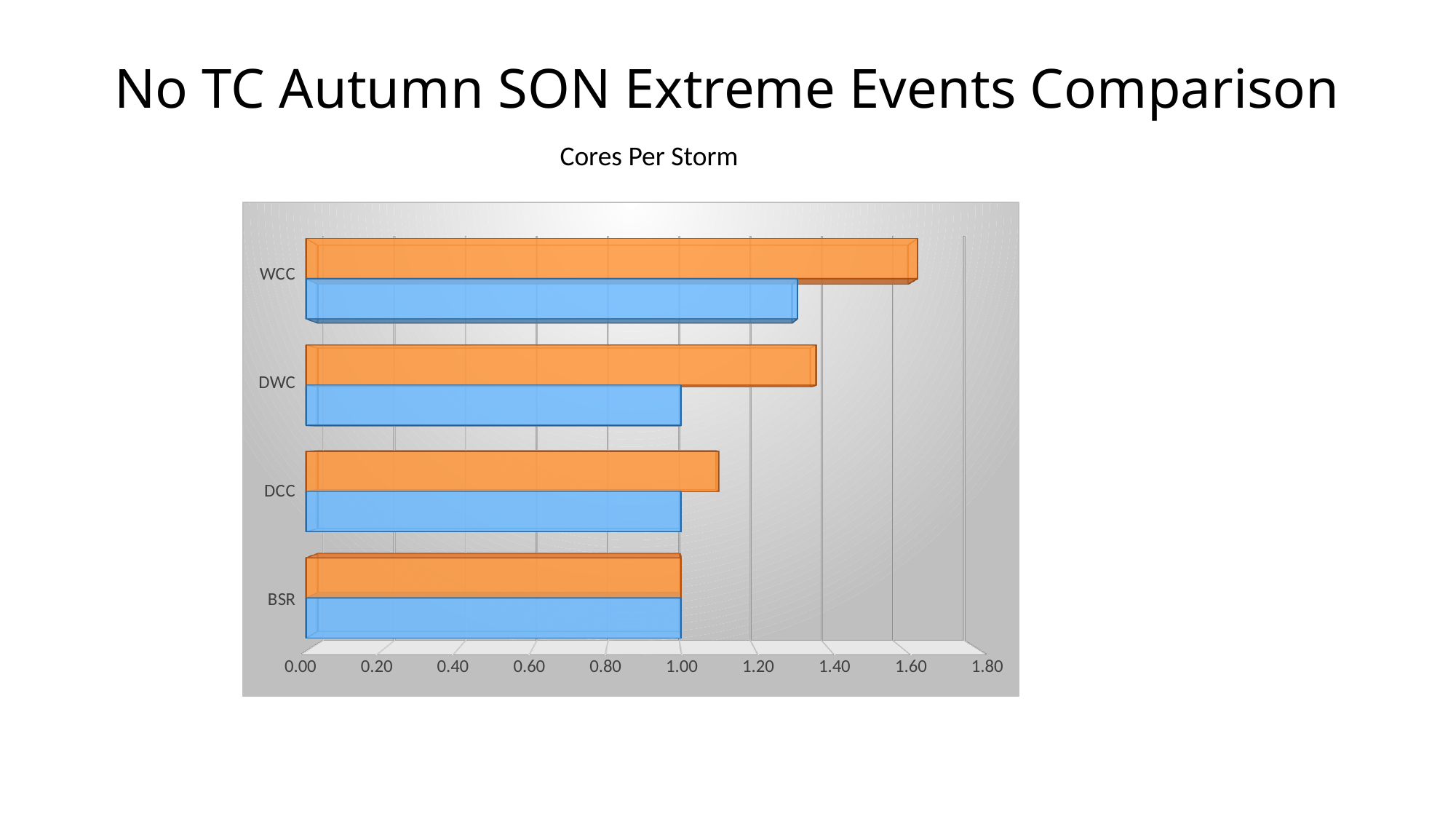
Is the value of the orange bar for DWC greater or less than 1.20? greater For WCC, which bar is longer, the orange one or the blue one? orange What is the title of the chart? Cores Per Storm Which has the larger orange bar, WCC or DWC? WCC Which category has the longest orange bar? WCC Is the value of the orange bar for DCC greater or less than 1.20? less What two colours are used for the bars in the chart? orange and blue How many categories are shown on the chart's vertical axis? 4 Is the value of the blue bar for WCC greater or less than 1.20? greater Which category has the shortest orange bar? BSR What kind of chart is shown on the slide? bar chart